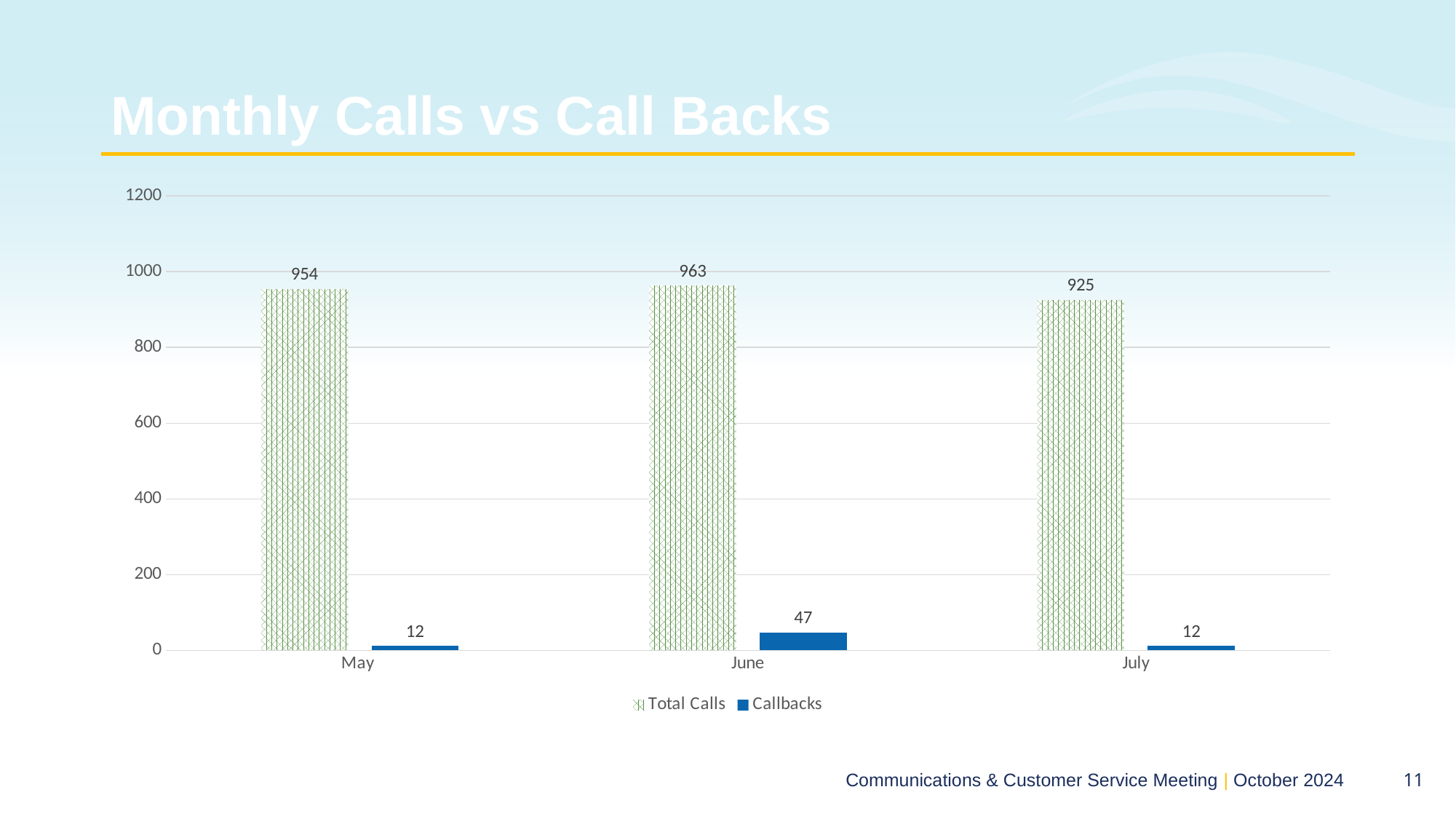
What is the difference between Callbacks in June and Callbacks in May? 35 How many series does the legend list? 2 How many months are shown on the x axis? 3 What is the value of Total Calls for July? 925 What is the difference between Total Calls in June and Total Calls in July? 38 Which month has the highest Total Calls? June Which is larger, Total Calls in May or Total Calls in July? Total Calls in May Which month has the lowest Total Calls? July What is the value of Callbacks for June? 47 What is the value of Total Calls for June? 963 Which month has the highest Callbacks? June What kind of chart is shown on the slide? Bar chart